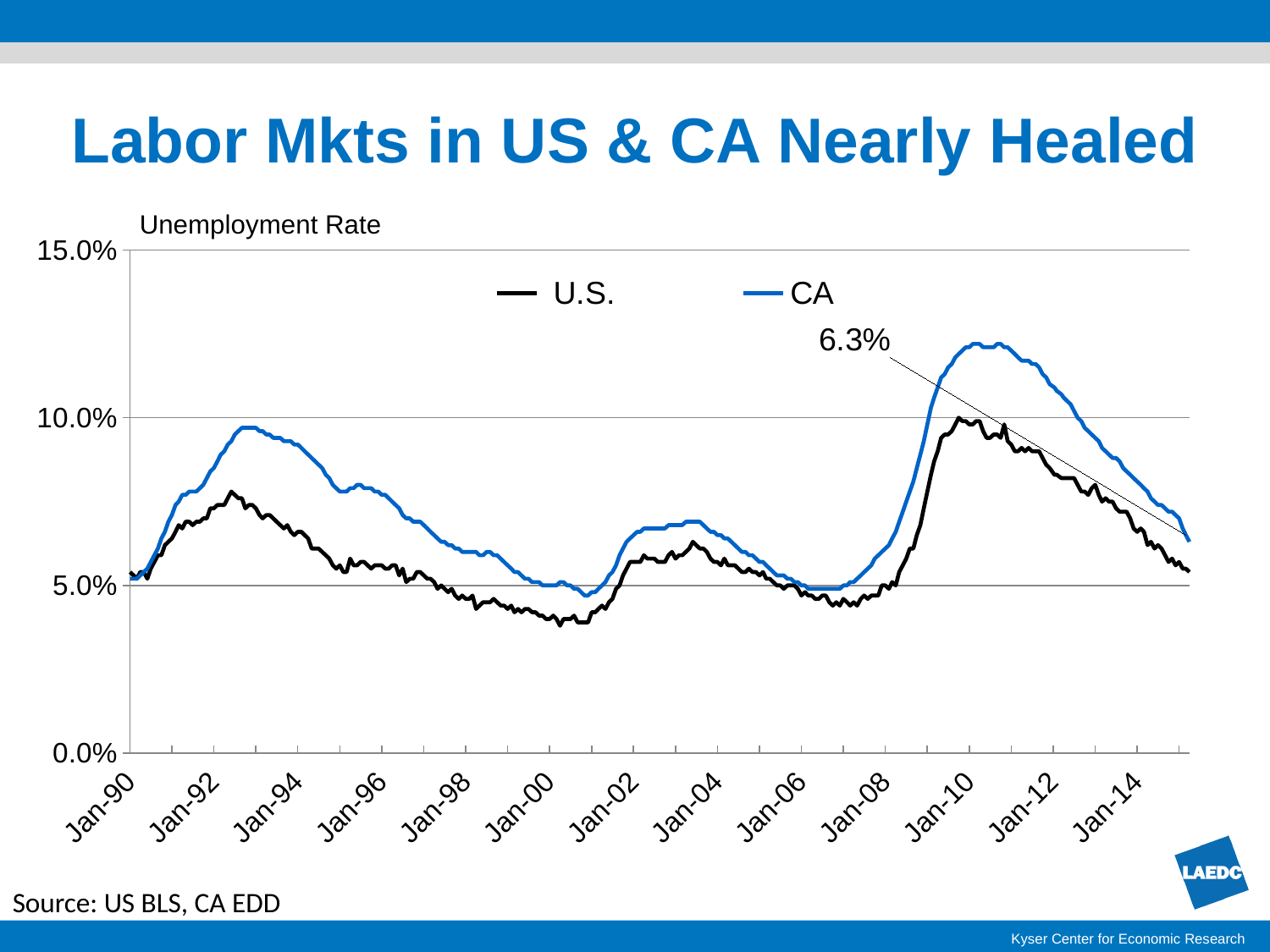
Is the value of the U.S. series around Jan-00 greater or less than 5.0%? less Is the value of the CA series around Jan-94 greater or less than 5.0%? greater What value is labeled at the end of the CA line? 6.3% What is the title shown above the chart? Unemployment Rate How many series does the legend list? 2 What kind of chart is shown on the slide? line chart Is the peak value of the CA series around 2010-2011 greater or less than 10.0%? greater Does the CA series rise or fall between Jan-08 and Jan-10? rise Which series reaches the highest value anywhere on the chart? CA Which series is higher around Jan-10, U.S. or CA? CA Does the U.S. series rise or fall between Jan-10 and Jan-14? fall What are the two series named in the legend? U.S. and CA